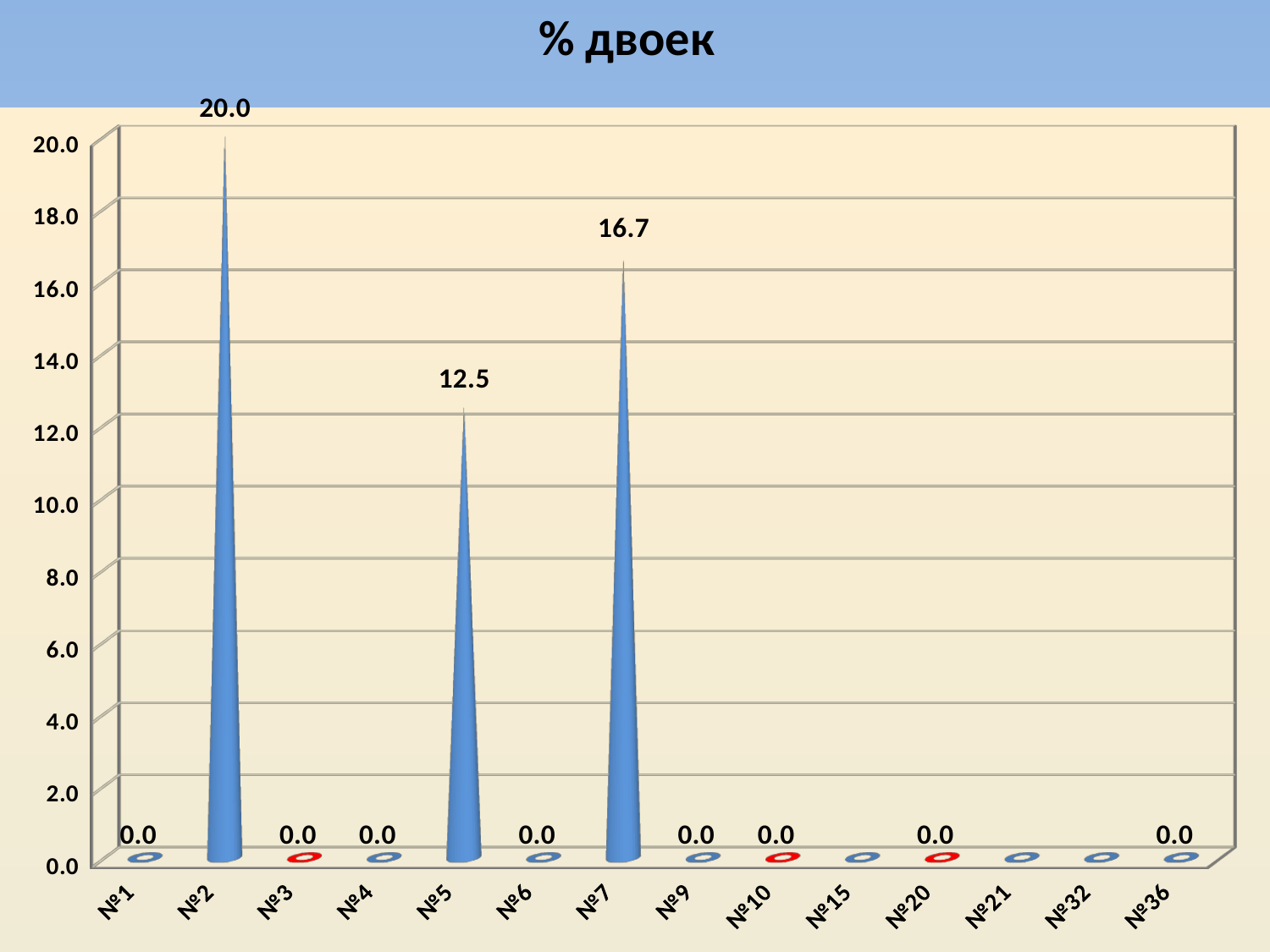
What is the value for №7? 16.7 Which is larger, the value for №5 or the value for №7? №7 What is the value for №2? 20.0 What is the value for №1? 0.0 Is the value for №5 greater or less than 10.0? greater What is the title of the chart? % двоек Which category has the highest value? №2 How many categories are shown on the x axis? 14 What kind of chart is shown on the slide? bar chart What is the difference between the values for №2 and №5? 7.5 What is the difference between the values for №7 and №5? 4.2 What is the value for №5? 12.5